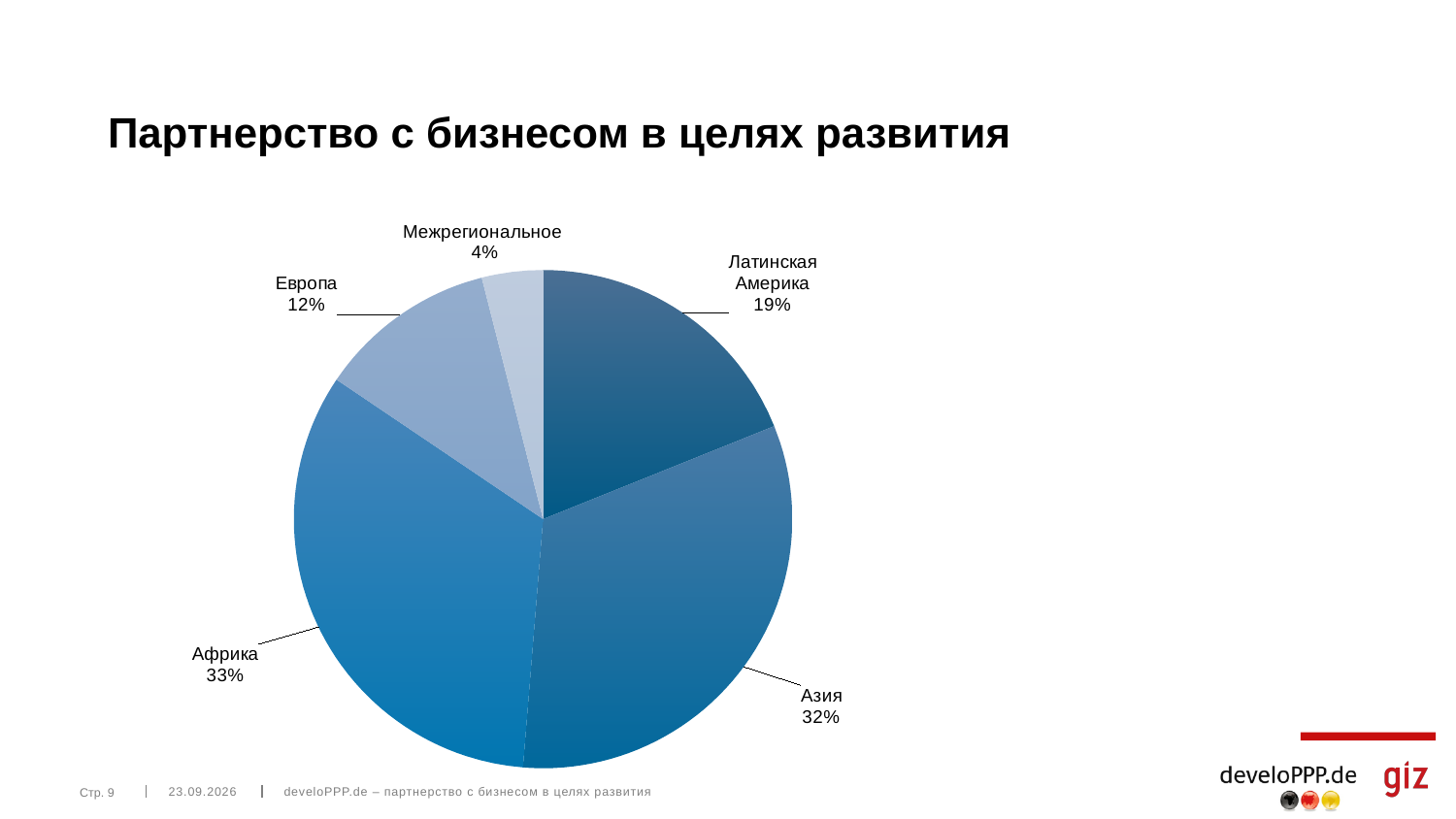
What is the value for Межрегиональное? 4% What kind of chart is shown on the slide? Pie chart Which category has the smallest slice of the pie? Межрегиональное What is the value shown for Азия? 32% What share of the pie does Европа represent? 12% What is the title of the slide containing the chart? Партнерство с бизнесом в целях развития Which category has the largest slice of the pie? Африка How many categories are shown in the pie chart? 5 What percentage is shown for Латинская Америка? 19% Which is larger, the slice for Азия or the slice for Европа? Азия What share of the pie does Африка account for? 33% What is the difference between the shares of Африка and Европа? 21%